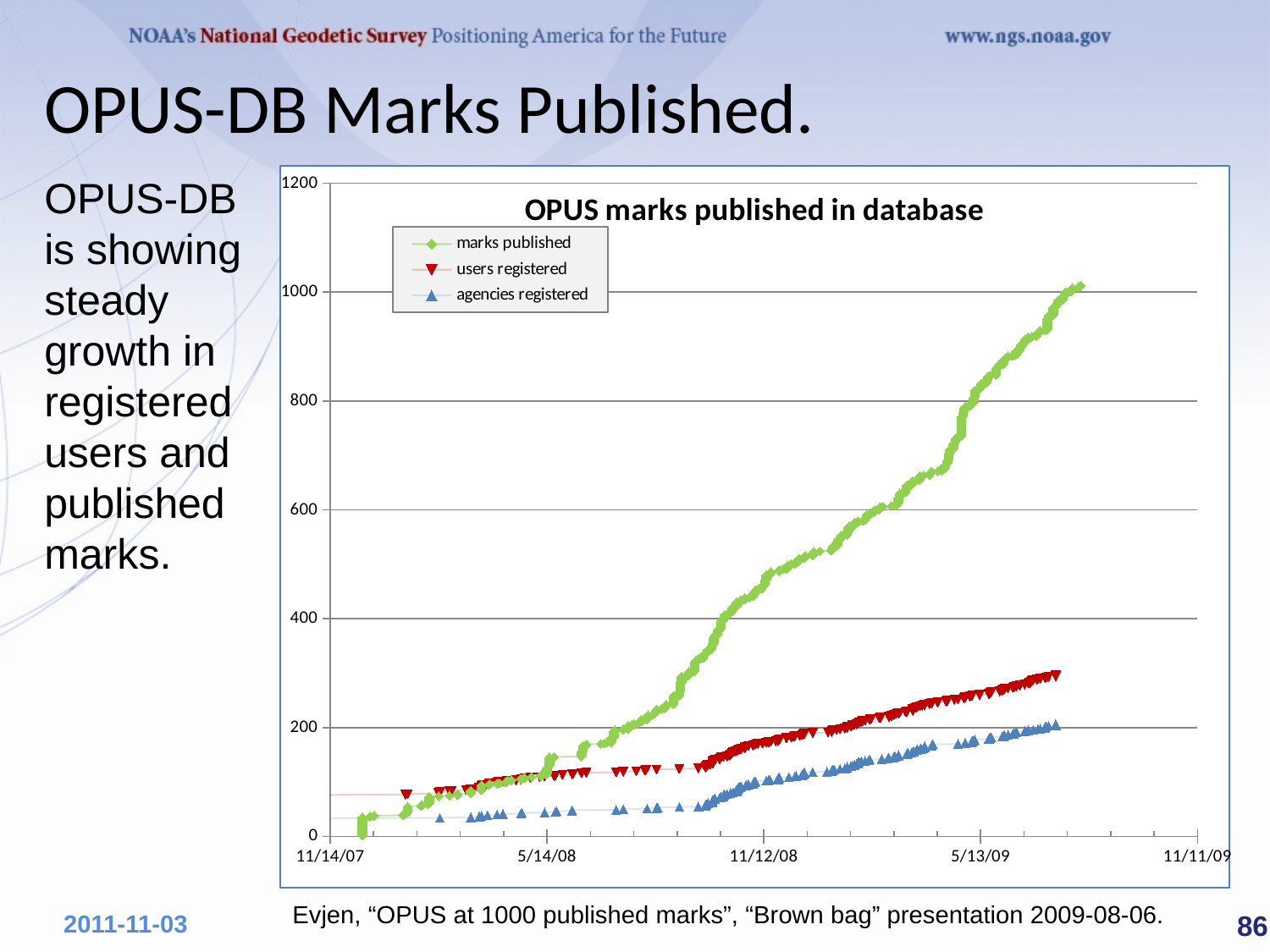
Is the value for 'marks published' at 5/13/09 greater or less than 600? greater What kind of chart is shown on the slide? line chart At 11/12/08, which is larger: 'marks published' or 'users registered'? marks published Which series has the lowest values on the chart? agencies registered Is the value for 'marks published' at 11/12/08 greater or less than 200? greater How many date labels are shown on the x axis? 5 Does the 'marks published' series rise or fall over time along the x axis? rise Which series are listed in the chart's legend? marks published, users registered, agencies registered What is the title of the chart? OPUS marks published in database Which series reaches the highest value on the chart? marks published Is the value for 'users registered' at 11/12/08 greater or less than 400? less How many series does the chart's legend list? 3